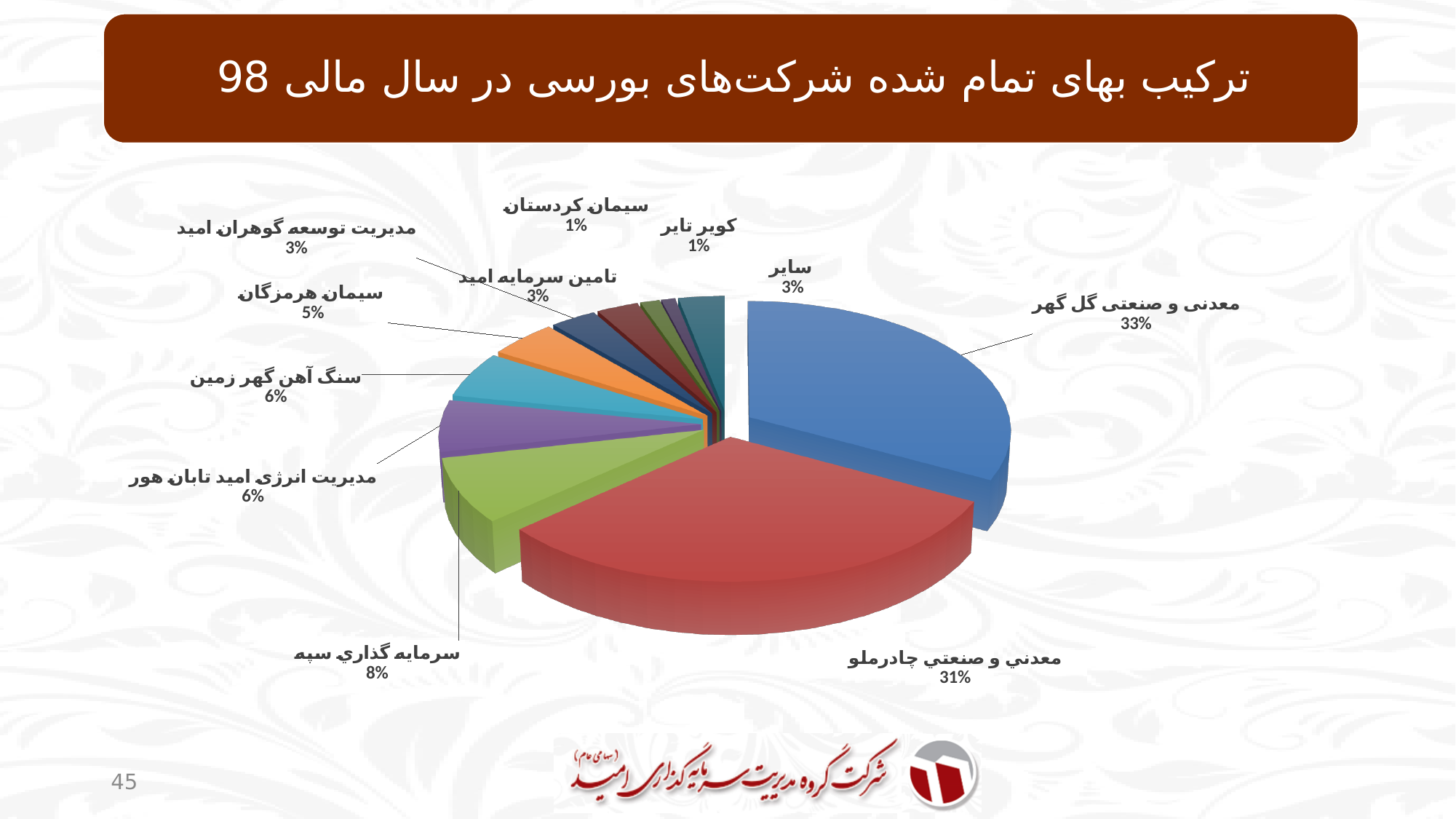
What is the value shown for سرمايه گذاري سپه? 8% What is the value shown for ساير? 3% How many slices does the pie chart have? 11 What is the difference between the values for سنگ آهن گهر زمين and سيمان كردستان? 5% Which is larger, the slice for سرمايه گذاري سپه or the slice for سيمان هرمزگان? سرمايه گذاري سپه What share of the pie does معدنی و صنعتی گل گهر hold? 33% What type of chart is shown on the slide? pie chart What is the title of the chart on the slide? ترکیب بهای تمام شده شرکت‌های بورسی در سال مالی 98 What is the difference in percentage points between معدنی و صنعتی گل گهر and معدني و صنعتي چادرملو? 2% What is the value shown for سيمان هرمزگان? 5% Which category has the largest slice of the pie? معدنی و صنعتی گل گهر What share of the pie does معدني و صنعتي چادرملو hold? 31%